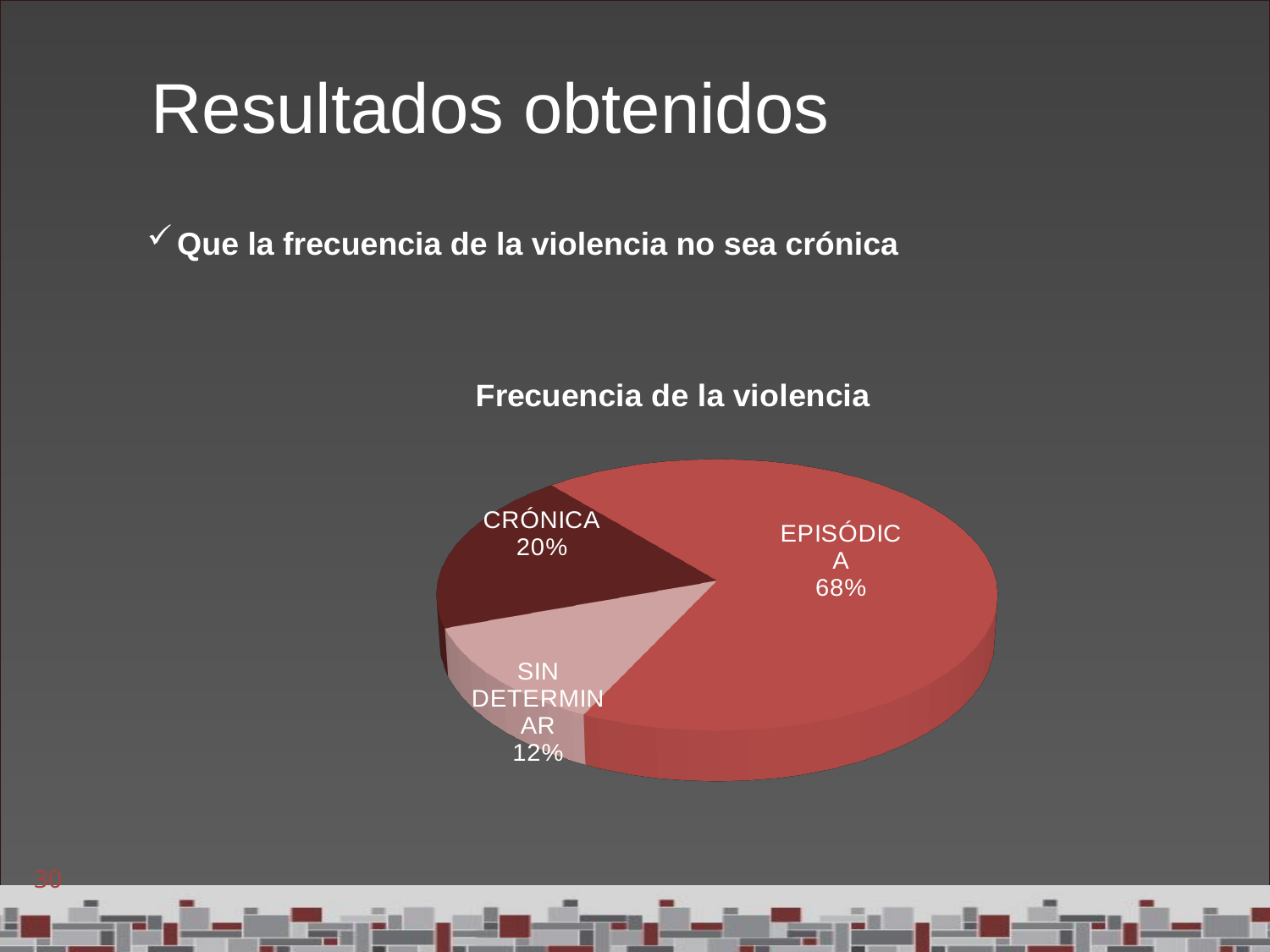
What is the difference in percentage points between EPISÓDICA and CRÓNICA? 48 What kind of chart is shown on the slide? pie chart What percentage of the pie is EPISÓDICA? 68% What is the difference in percentage points between CRÓNICA and SIN DETERMINAR? 8 What percentage of the pie is SIN DETERMINAR? 12% What percentage of the pie is CRÓNICA? 20% What share of the pie do CRÓNICA and SIN DETERMINAR make up together? 32% How many slices does the pie chart have? 3 What is the title of the chart? Frecuencia de la violencia Which slice of the pie is the largest? EPISÓDICA Which is larger, the CRÓNICA slice or the SIN DETERMINAR slice? CRÓNICA Which slice of the pie is the smallest? SIN DETERMINAR